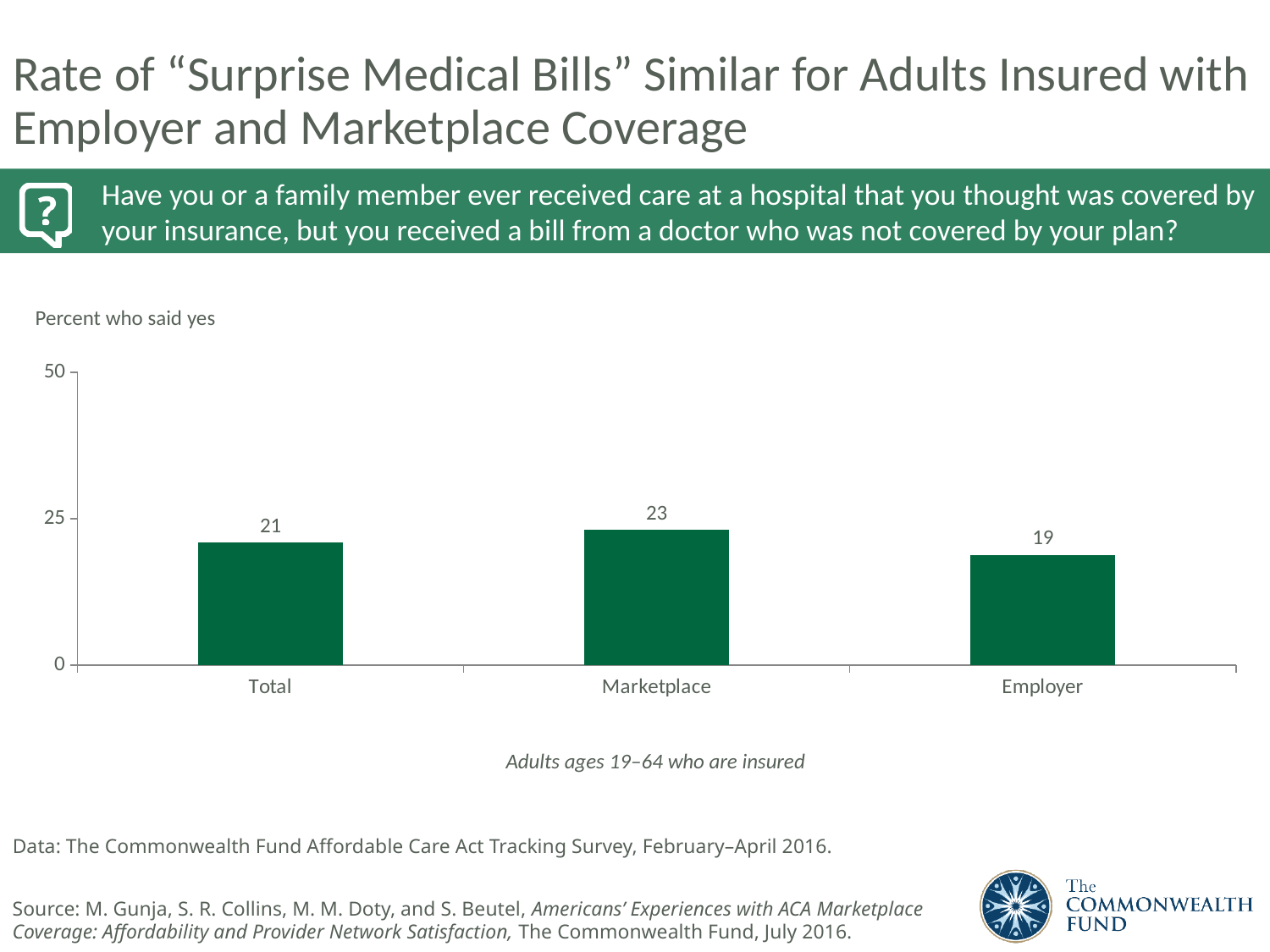
What is the value for Marketplace? 23 How many categories are shown on the x axis? 3 What is the difference between the values for Marketplace and Employer? 4 Which category has the lowest value? Employer What kind of chart is shown on the slide? bar chart Which is larger, the value for Marketplace or the value for Employer? Marketplace Is the value for Employer greater or less than 25? less What is the value for Total? 21 What is the difference between the values for Total and Employer? 2 What is the label above the chart describing what the values represent? Percent who said yes Which category has the highest value? Marketplace What is the value for Employer? 19